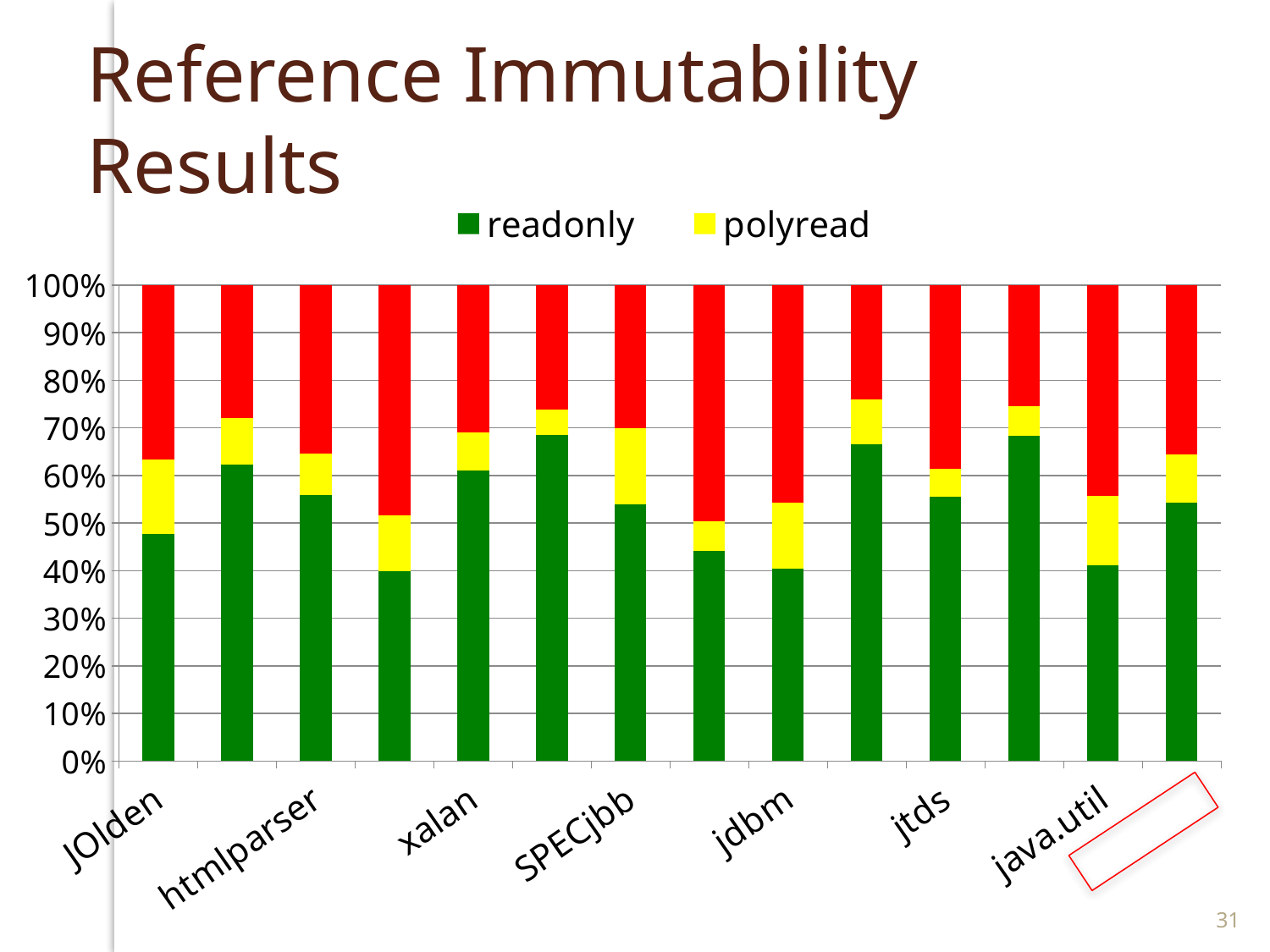
What colour represents the readonly series? green What is the highest value shown on the vertical axis? 100% What kind of chart is shown on the slide? stacked bar chart What is the total height of each stacked bar in the chart? 100% What are the two series named in the legend? readonly and polyread How many bars are plotted in the chart? 14 How many series does the legend list? 2